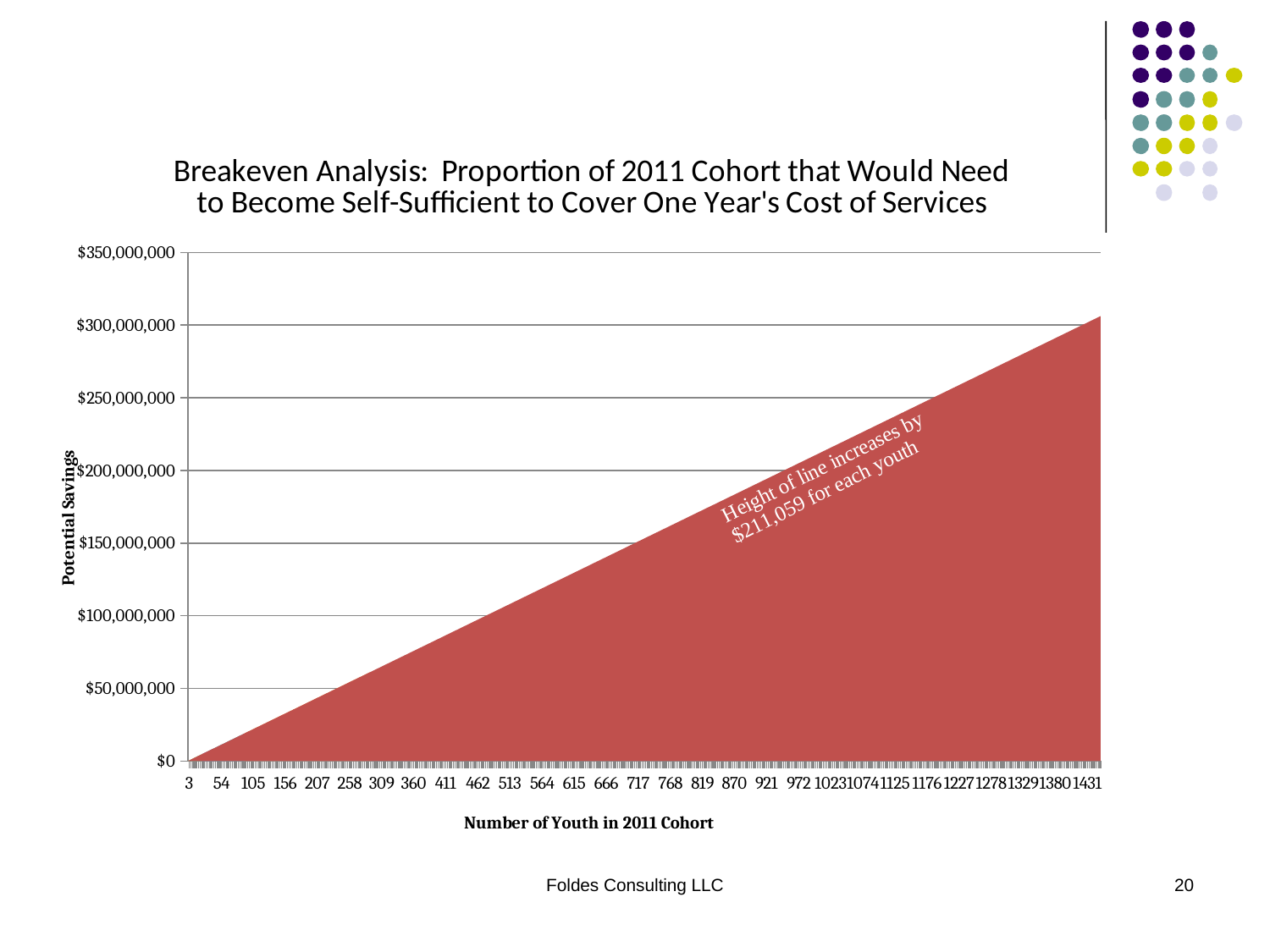
Is the potential savings value at 360 youth greater or less than $100,000,000? less At which number of youth on the x axis is the potential savings highest? 1431 Is the potential savings value at 564 youth greater or less than $100,000,000? greater What is the title of the chart? Breakeven Analysis: Proportion of 2011 Cohort that Would Need to Become Self-Sufficient to Cover One Year's Cost of Services Which has the larger potential savings: 258 youth or 972 youth? 972 youth At which number of youth on the x axis is the potential savings lowest? 3 According to the annotation on the chart, by how much does the height of the line increase for each youth? $211,059 Is the potential savings value at 1023 youth greater or less than $200,000,000? greater Do the potential savings rise or fall as the number of youth in the 2011 cohort increases? Rise What kind of chart is shown on the slide? Area chart What is the label of the vertical axis? Potential Savings